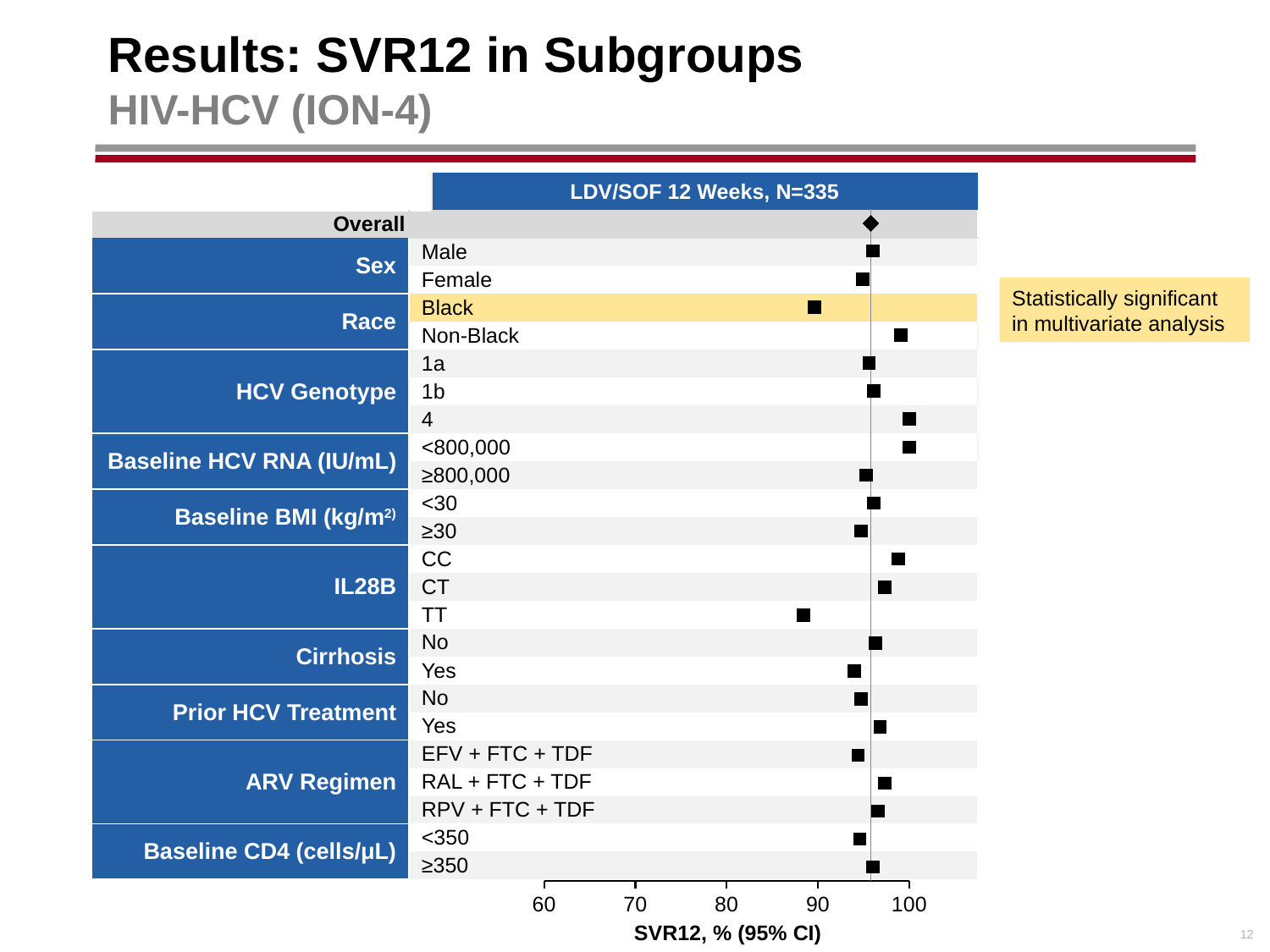
Is the SVR12 value for the Non-Black subgroup greater or less than 90? greater Is the SVR12 value for HCV Genotype 4 greater or less than 90? greater Which has the higher SVR12 point estimate, IL28B CC or IL28B TT? CC How many subgroup rows (excluding Overall) are plotted in the chart? 23 Is the Overall SVR12 value greater or less than 80? greater What treatment arm and sample size are shown in the chart header? LDV/SOF 12 Weeks, N=335 Which subgroup row is highlighted in yellow as statistically significant in multivariate analysis? Black How many ARV Regimen subgroups are plotted in the chart? 3 What is the x-axis label of the chart? SVR12, % (95% CI) Which has the higher SVR12 point estimate, the Black or the Non-Black subgroup? Non-Black Which subgroup has the lowest SVR12 point estimate in the chart? IL28B TT